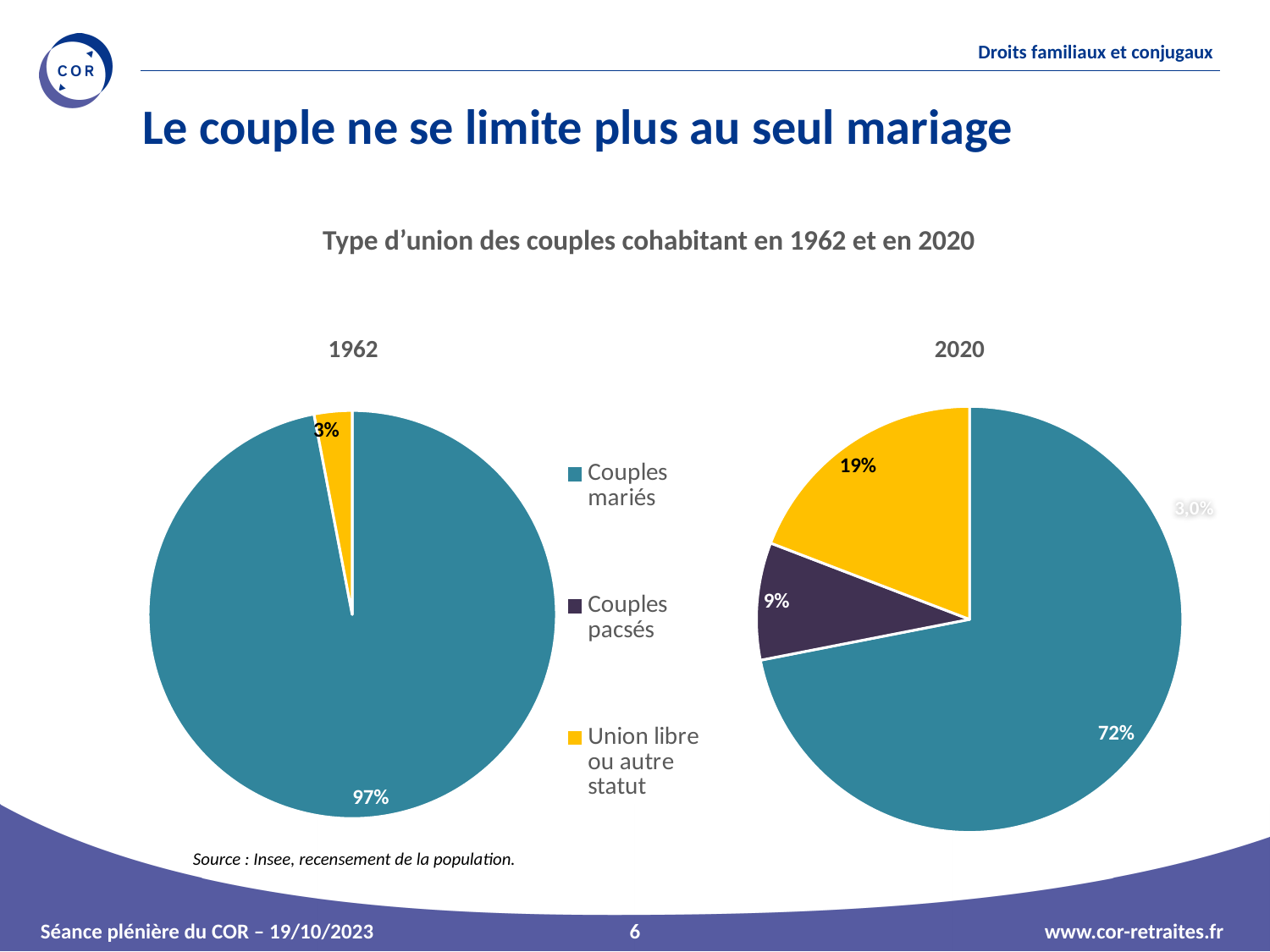
In the 2020 pie chart, which category has the largest slice? Couples mariés In the 2020 pie chart, what share is shown for 'Union libre ou autre statut'? 19% In the 1962 pie chart, what share of cohabiting couples were married couples (Couples mariés)? 97% What is the title of the chart on this slide? Type d'union des couples cohabitant en 1962 et en 2020 In the 2020 pie chart, what share is shown for 'Couples pacsés'? 9% In the 2020 pie chart, which category has the smallest slice? Couples pacsés In the 2020 pie chart, what share of cohabiting couples were married couples (Couples mariés)? 72% How many categories does the legend list? 3 What is the difference in percentage points between the share of married couples in 1962 and in 2020? 25 percentage points What type of chart is used on this slide? Pie chart In the 1962 pie chart, what share is shown for 'Union libre ou autre statut'? 3% In the 2020 pie chart, which is larger: the share of 'Couples pacsés' or the share of 'Union libre ou autre statut'? Union libre ou autre statut